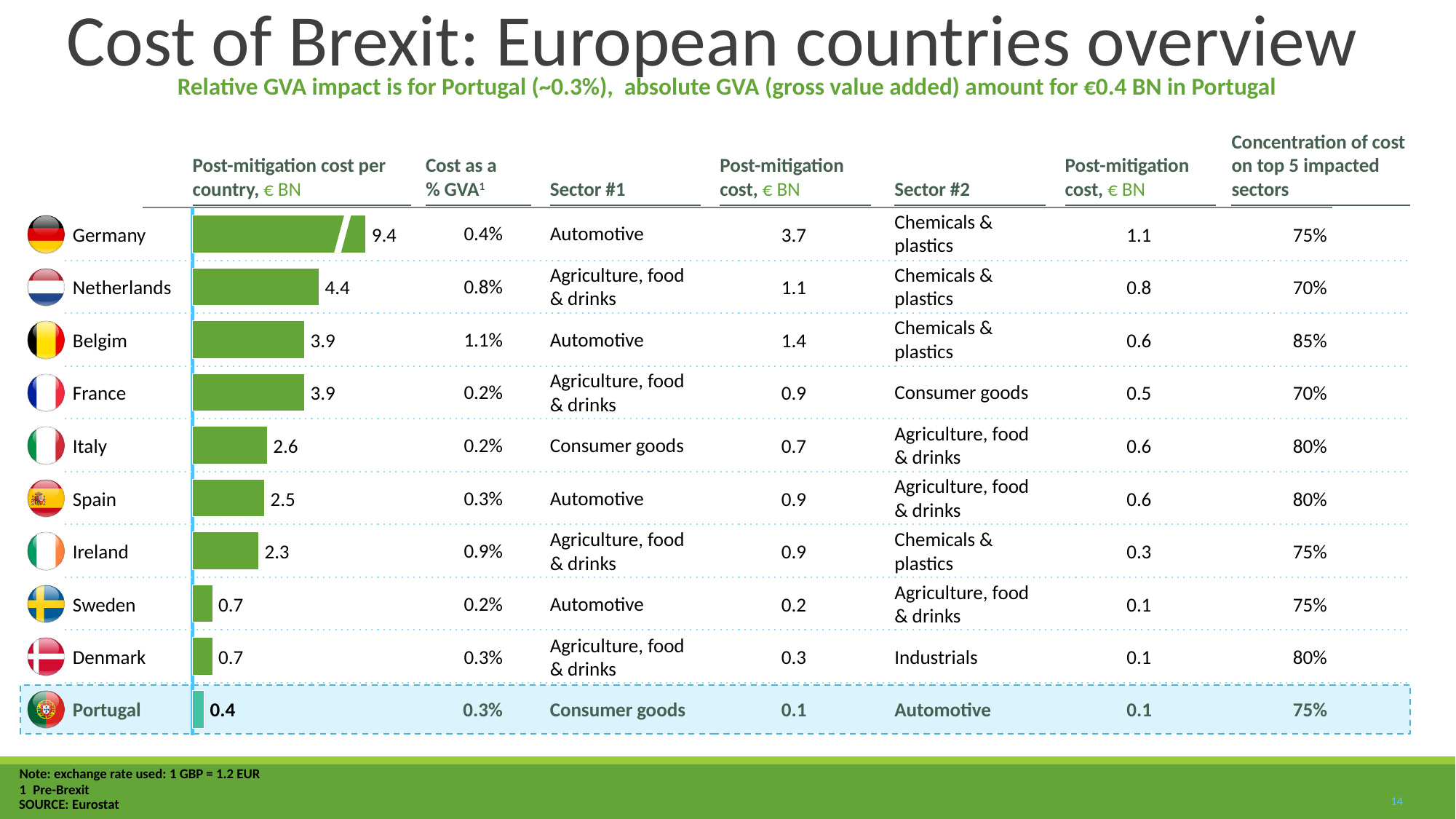
Which country has the highest post-mitigation cost per country in the bar chart? Germany What is the difference between the post-mitigation cost per country for Germany and the Netherlands? 5.0 Which two countries both have a post-mitigation cost per country of 3.9? Belgim and France How many countries are shown in the post-mitigation cost per country bar chart? 10 What is the post-mitigation cost per country for Ireland? 2.3 What kind of chart shows the post-mitigation cost per country? bar chart Do the post-mitigation cost per country bars rise or fall going down the list from Germany to Portugal? fall Which country has the lowest post-mitigation cost per country in the bar chart? Portugal Which has a larger post-mitigation cost per country, Italy or Spain? Italy What is the post-mitigation cost per country for Portugal? 0.4 What is the post-mitigation cost per country for the Netherlands? 4.4 Which country's bar in the post-mitigation cost chart is highlighted in a different colour from the others? Portugal